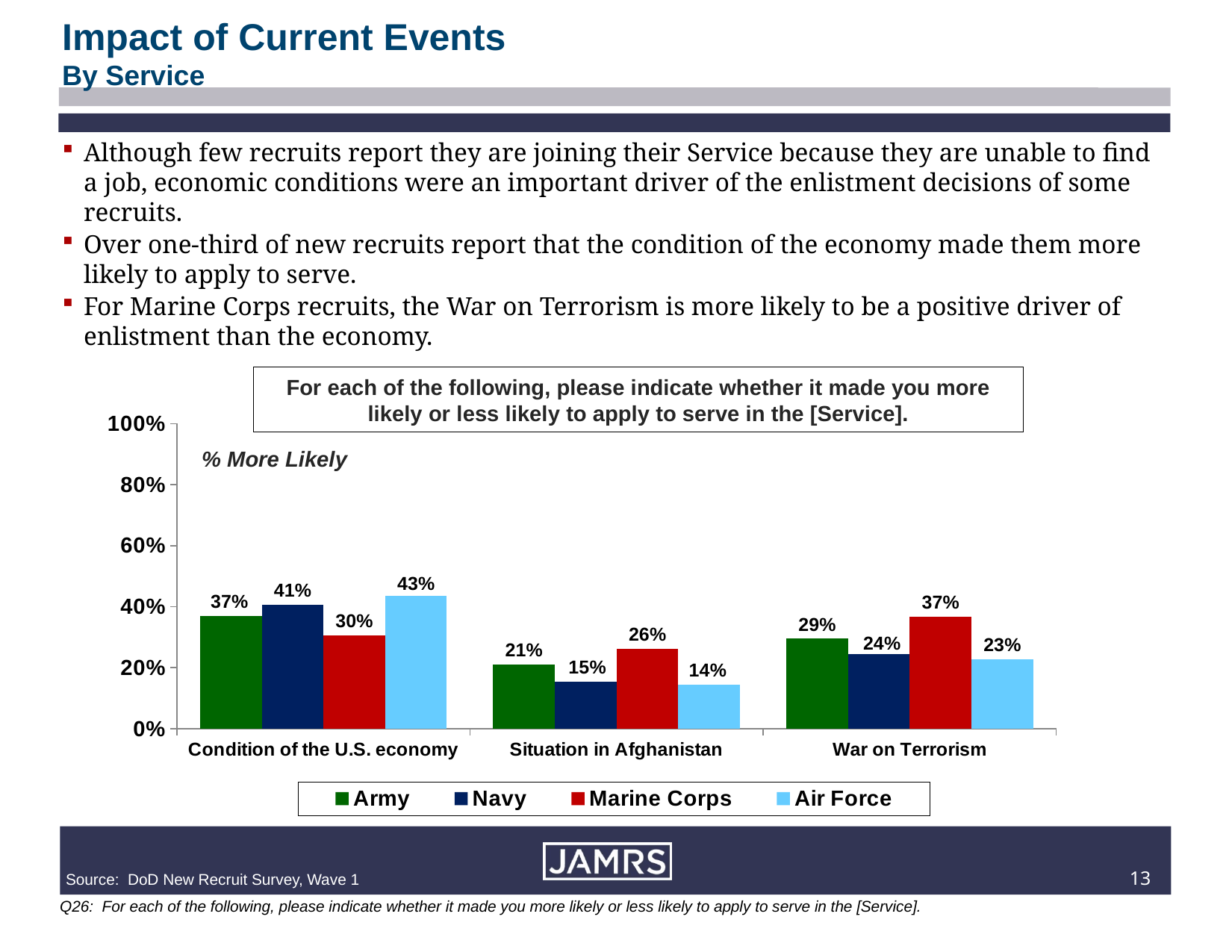
What percentage of Air Force recruits said the condition of the U.S. economy made them more likely to apply? 43% Which service has the lowest value for Situation in Afghanistan? Air Force What is the value for Marine Corps for War on Terrorism? 37% How many series does the legend list? 4 What kind of chart is shown on the slide? Bar chart Which colour represents Marine Corps in the chart? Red For Marine Corps, which is larger: the value for Condition of the U.S. economy or the value for War on Terrorism? War on Terrorism Which service has the highest value for Condition of the U.S. economy? Air Force How many categories are shown on the x axis? 3 Is the Army value for Condition of the U.S. economy greater or less than 20%? greater What is the difference between the Marine Corps and Army values for War on Terrorism? 8% What is the value for Navy for Situation in Afghanistan? 15%